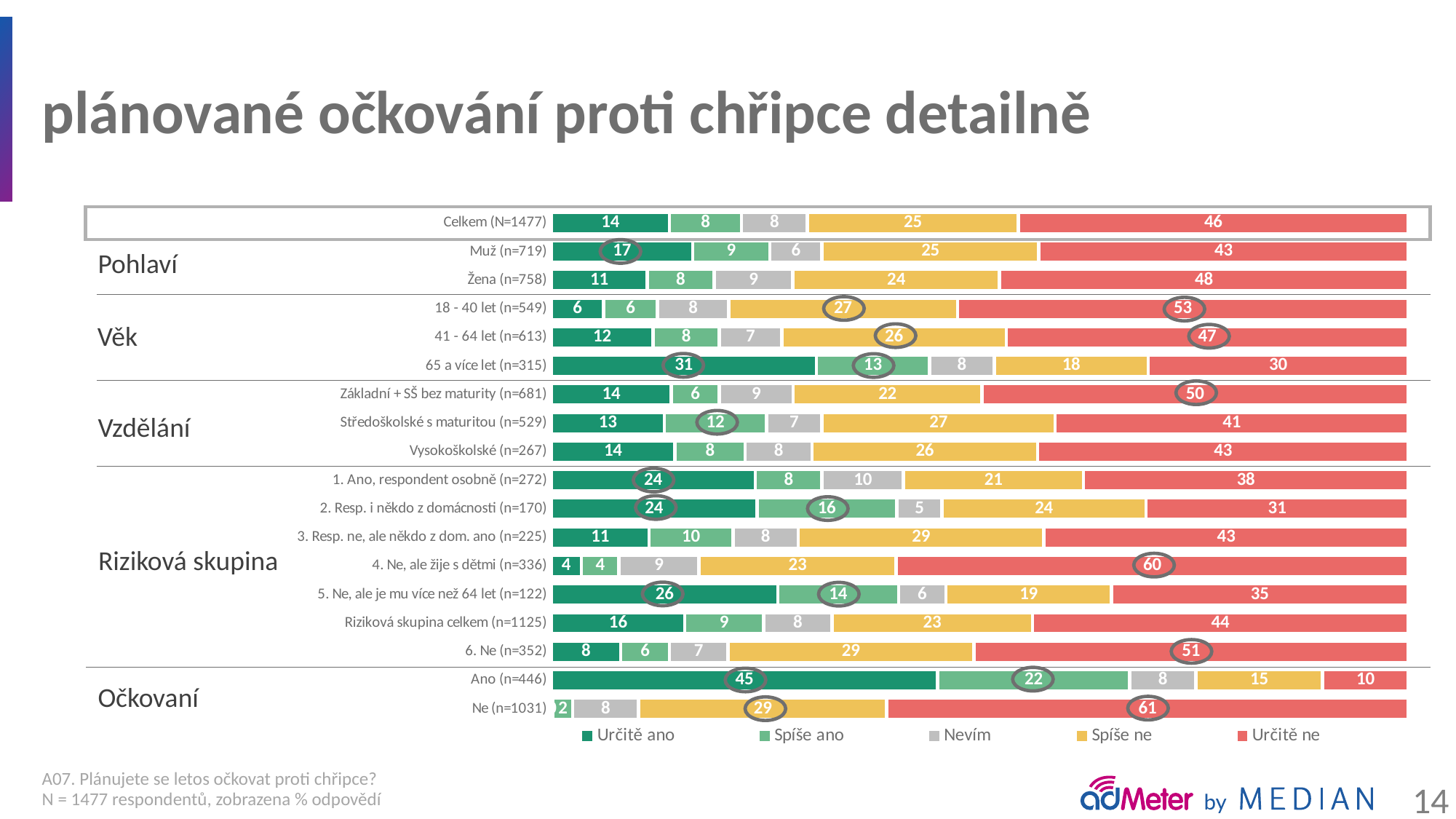
Which category has the lowest value for 'Určitě ne'? Ano (n=446) What colour represents 'Nevím' in the legend? Grey What is the difference between the 'Určitě ano' values for 'Muž (n=719)' and 'Žena (n=758)'? 6 What kind of chart is shown on the slide? Stacked bar chart How many bars (categories) are plotted in the chart? 18 What is the value of 'Určitě ne' for 'Celkem (N=1477)'? 46 What is the value of 'Nevím' for '1. Ano, respondent osobně (n=272)'? 10 What is the total of the stacked bar for 'Ano (n=446)'? 100 What is the value of 'Určitě ano' for '65 a více let (n=315)'? 31 Which category has the highest value for 'Určitě ano'? Ano (n=446) How many series does the legend list? 5 Which has the larger 'Spíše ne' value: '18 - 40 let (n=549)' or '65 a více let (n=315)'? 18 - 40 let (n=549)